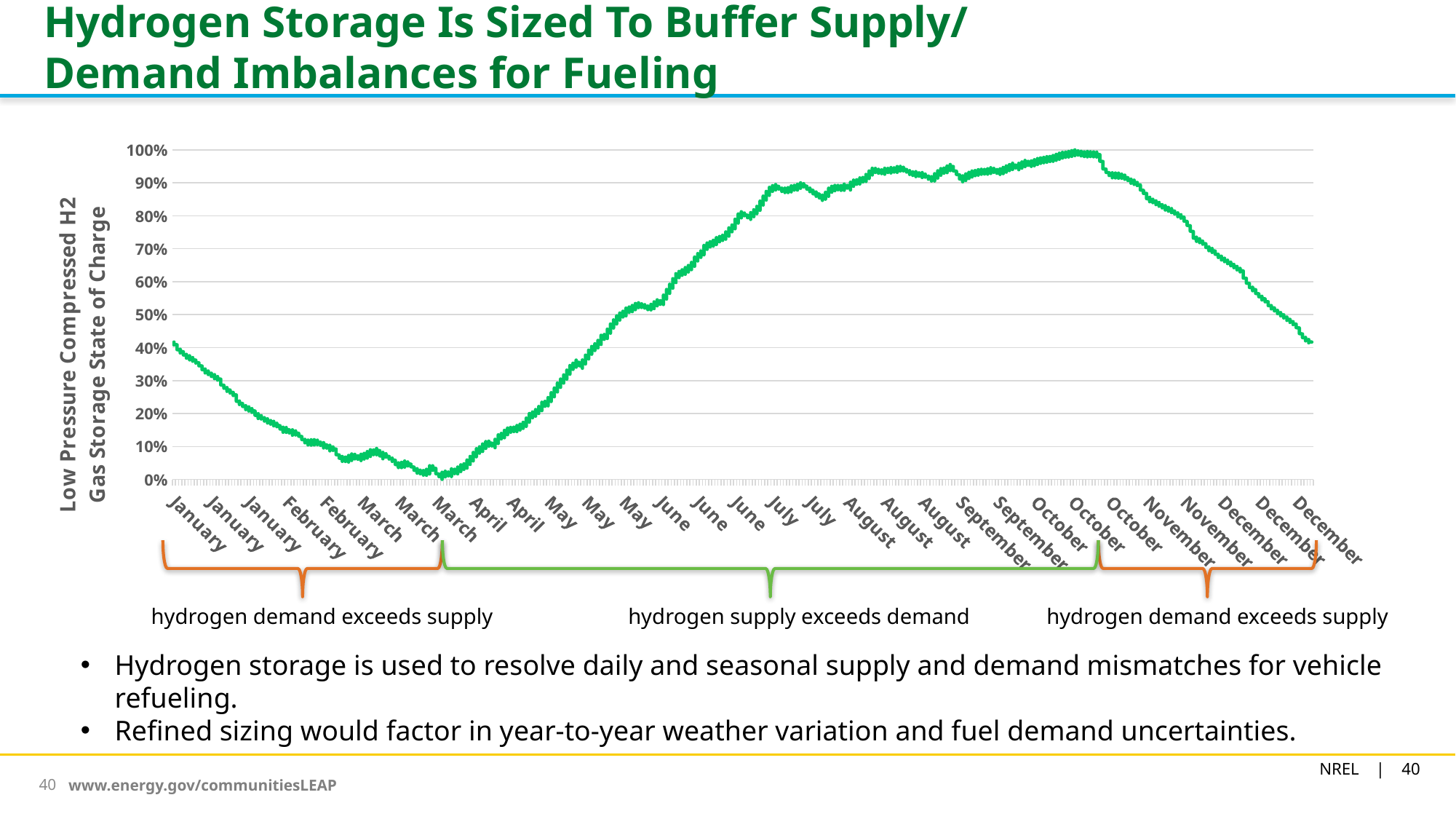
In which month does the storage state of charge reach its highest point? October Is the storage state of charge at the end of December greater or less than 50%? less Does the storage state of charge rise or fall from January to March? fall Does the storage state of charge rise or fall from October to December? fall Is the lowest storage state of charge in March greater or less than 10%? less What kind of chart is shown on the slide? line chart Does the storage state of charge rise or fall from March to October? rise Is the storage state of charge in July greater or less than 80%? greater In which month does the storage state of charge reach its lowest point? March What is the label of the vertical axis of the chart? Low Pressure Compressed H2 Gas Storage State of Charge According to the annotation below the chart, what condition applies from March to October? hydrogen supply exceeds demand